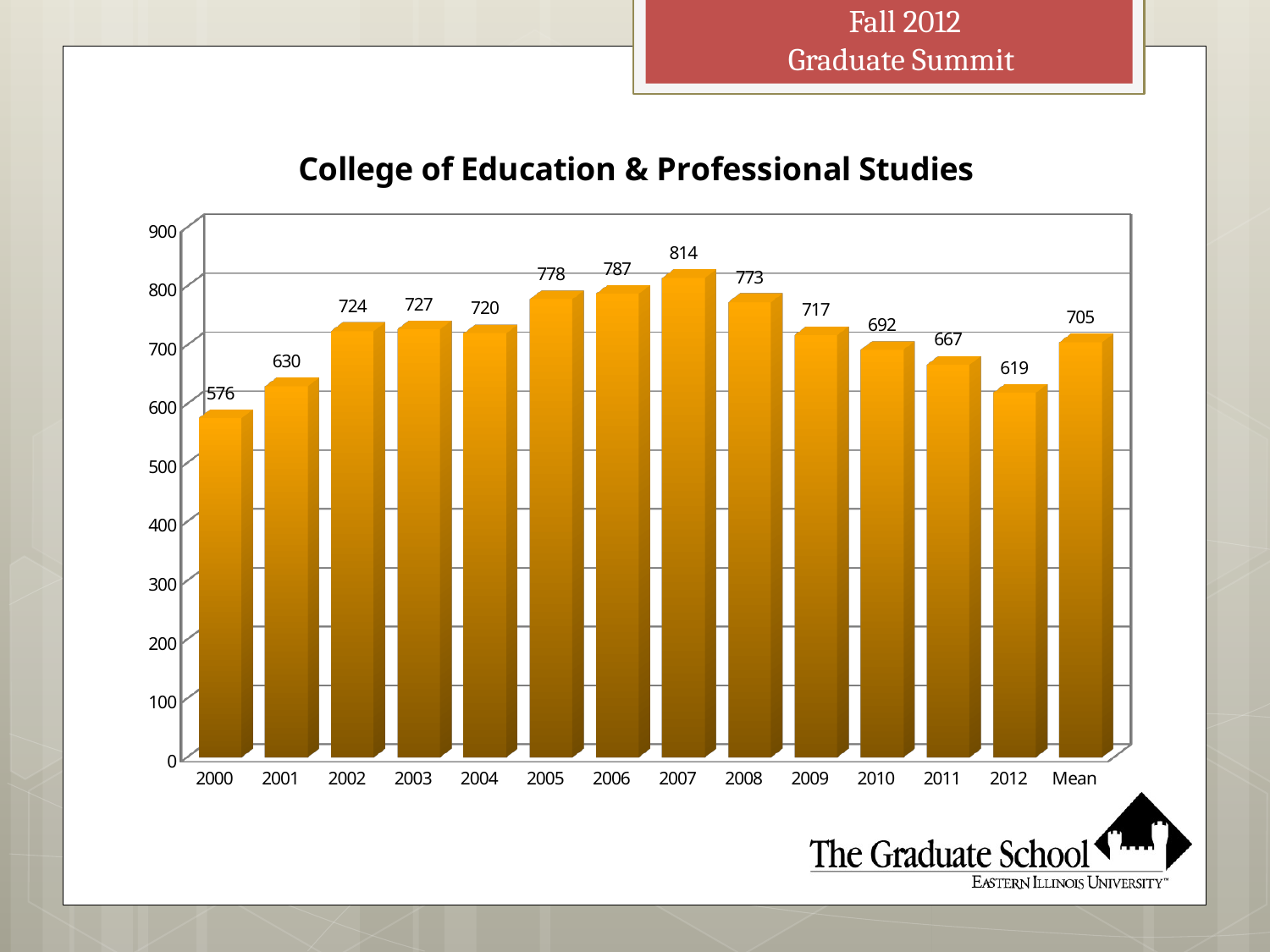
What is the difference between the values for 2007 and 2012? 195 What is the title of the chart? College of Education & Professional Studies What is the value for 2000? 576 What kind of chart is shown on the slide? bar chart What is the value for 2007? 814 How many categories are shown on the x axis? 14 Is the value for 2011 greater or less than 700? less Which is larger, the value for 2002 or the value for 2003? 2003 Which category has the highest value? 2007 Which category has the lowest value? 2000 Do the values rise or fall from 2007 to 2012? fall What is the value shown for Mean? 705